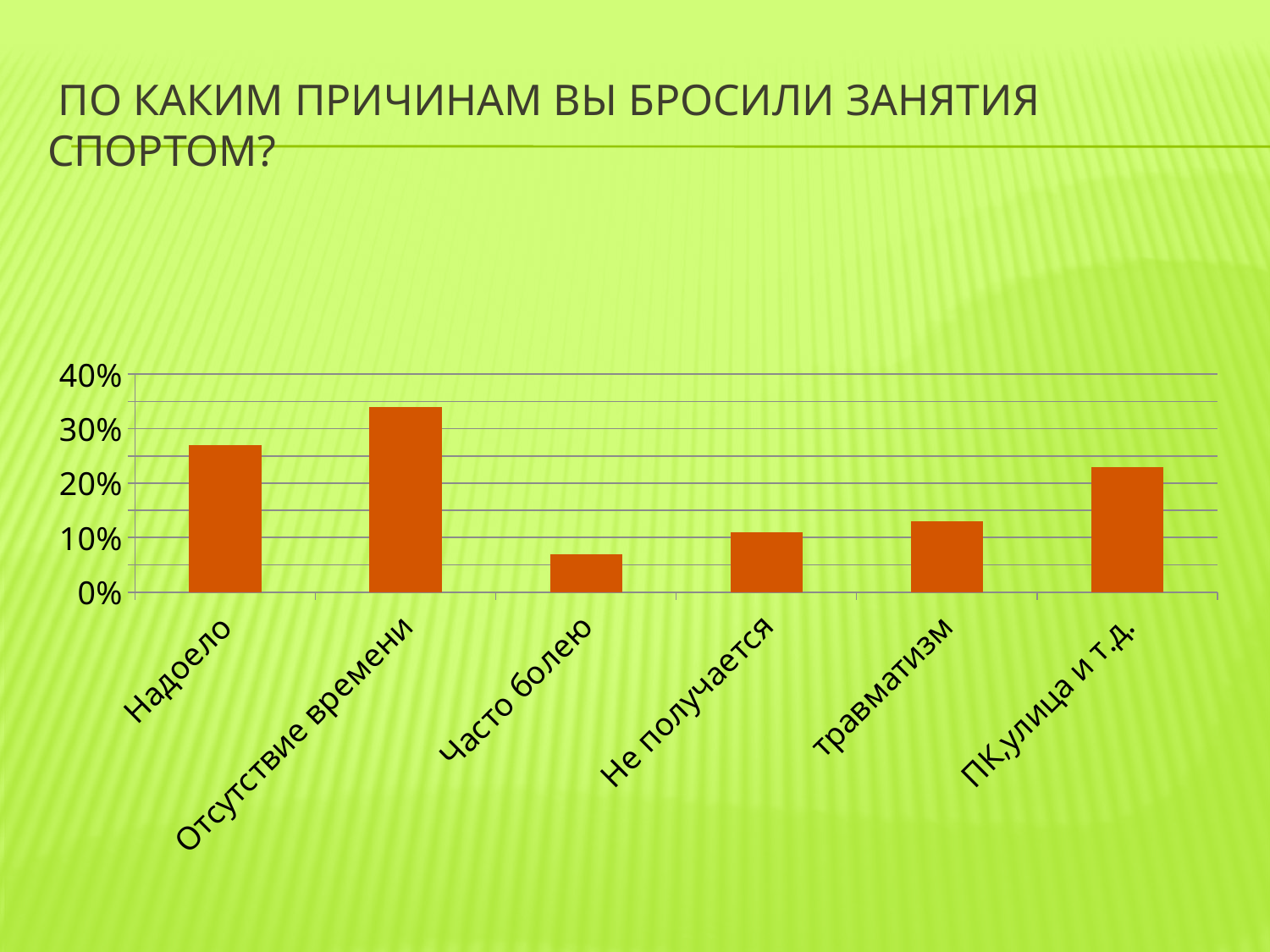
What is the title of the slide containing the chart? По каким причинам вы бросили занятия спортом? How many categories are shown on the x axis of the chart? 6 Is the value for травматизм greater or less than 20%? less Is the value for ПК,улица и т.д. greater or less than 30%? less Which category has the lowest bar in the chart? Часто болею Which category has the highest bar in the chart? Отсутствие времени Which is larger, the value for травматизм or the value for ПК,улица и т.д.? ПК,улица и т.д. Is the value for Надоело greater or less than 20%? greater What kind of chart is shown on the slide? bar chart Which is larger, the value for Надоело or the value for Не получается? Надоело